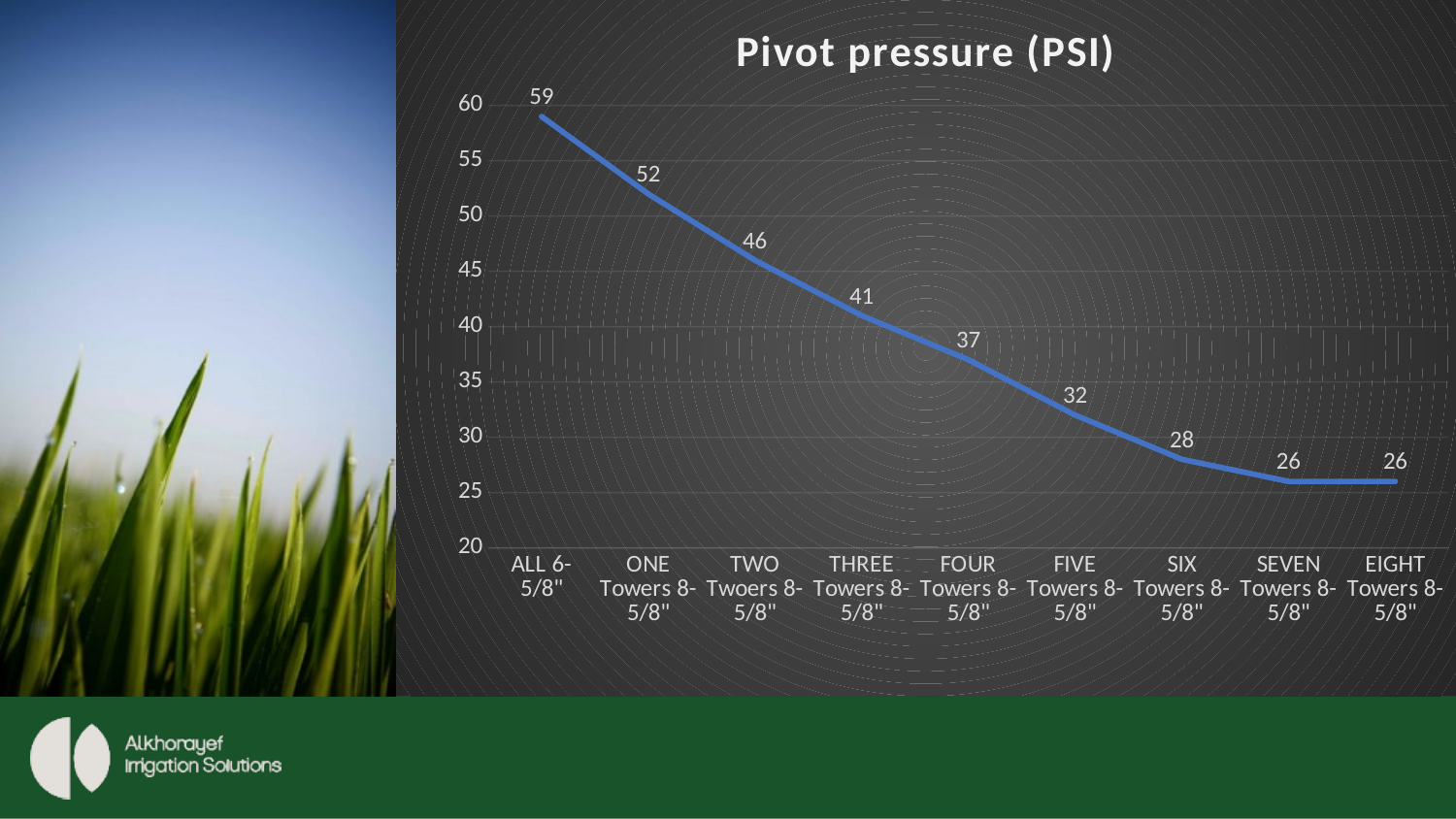
What is the title of the chart? Pivot pressure (PSI) What kind of chart is shown on the slide? Line chart What is the pivot pressure (PSI) for SIX Towers 8-5/8"? 28 Which has a higher pivot pressure, TWO Towers 8-5/8" or FIVE Towers 8-5/8"? TWO Towers 8-5/8" How many categories are plotted on the x axis? 9 Which category has the highest pivot pressure? ALL 6-5/8" What is the difference in pivot pressure between THREE Towers 8-5/8" and FIVE Towers 8-5/8"? 9 What is the lowest pivot pressure value shown on the chart? 26 What is the pivot pressure (PSI) for FOUR Towers 8-5/8"? 37 Do the pivot pressure values rise or fall from left to right along the x axis? Fall What is the difference in pivot pressure between ALL 6-5/8" and ONE Towers 8-5/8"? 7 What is the pivot pressure (PSI) for ALL 6-5/8"? 59